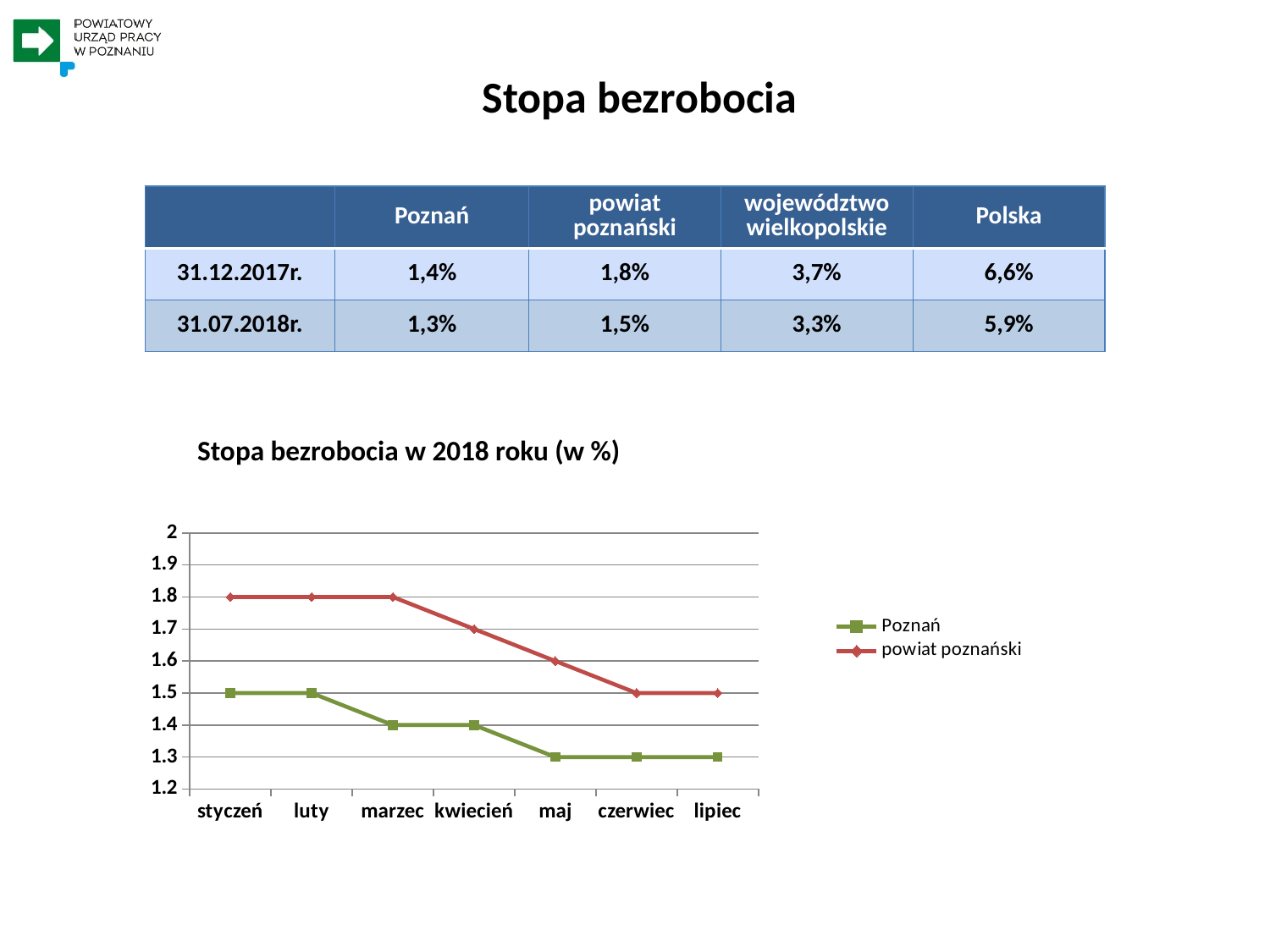
What is the value for powiat poznański in maj? 1.6 What is the difference between powiat poznański and Poznań in styczeń? 0.3 How many series does the chart legend list? 2 How many months are shown on the x axis of the chart? 7 Is the value for Poznań in maj greater or less than 1.4? less Do the values for powiat poznański rise or fall from styczeń to lipiec? fall What is the title of the chart? Stopa bezrobocia w 2018 roku (w %) What is the value for Poznań in styczeń? 1.5 What is the value for Poznań in lipiec? 1.3 Which series has the higher value in czerwiec, Poznań or powiat poznański? powiat poznański What type of chart is shown on the slide? line chart What is the value for powiat poznański in kwiecień? 1.7